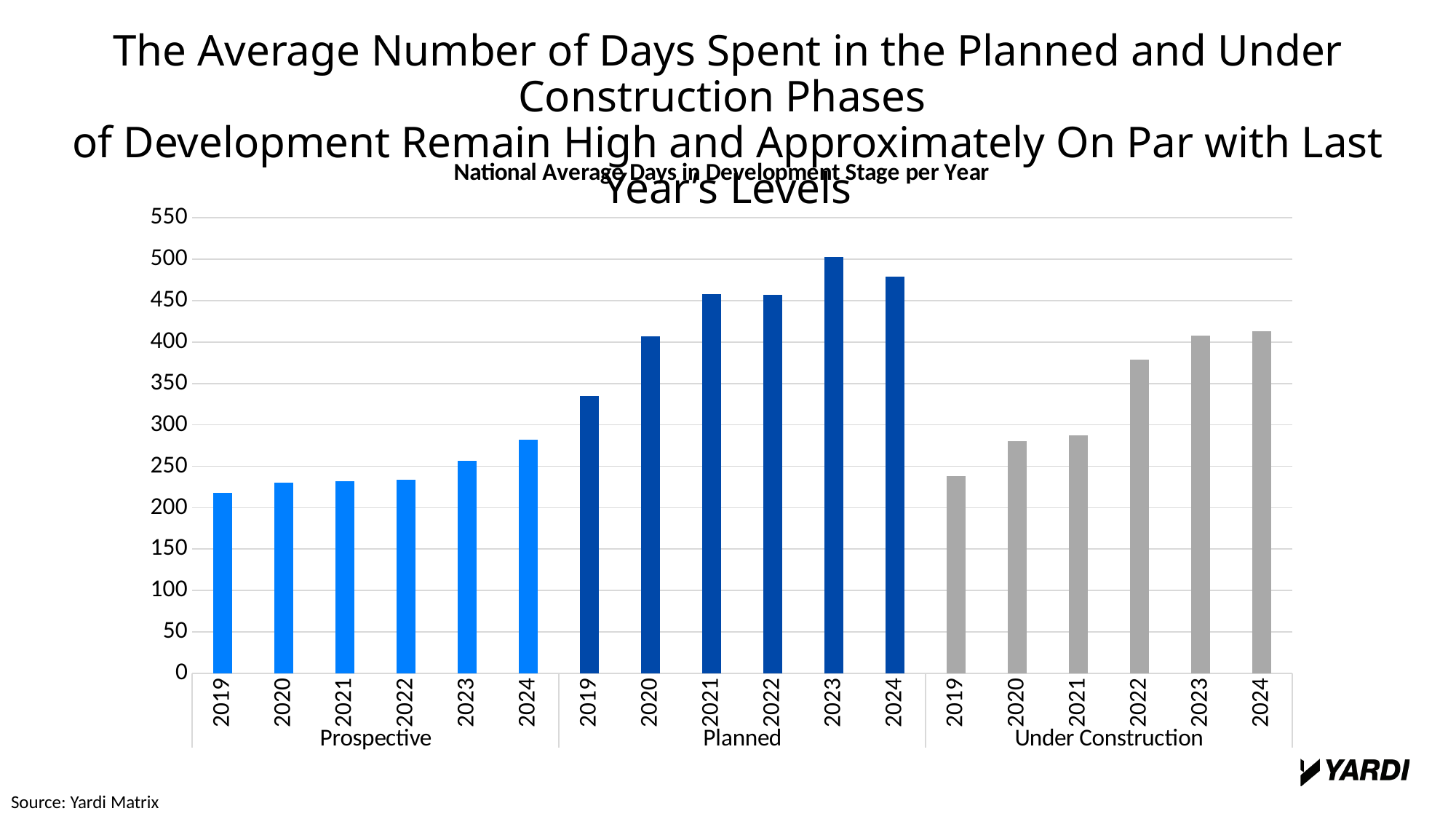
Which development stage and year has the highest average number of days? Planned, 2023 Which is larger: the value for Prospective in 2023 or the value for Under Construction in 2023? Under Construction in 2023 Is the value for Prospective in 2024 greater or less than 300? less Which is larger: the value for Planned in 2021 or the value for Under Construction in 2021? Planned in 2021 Is the value for Under Construction in 2022 greater or less than 350? greater What kind of chart is shown on the slide? bar chart Is the value for Planned in 2019 greater or less than 300? greater Do the Prospective values rise or fall from 2019 to 2024? rise How many bars are plotted in the chart? 18 Which development stage and year has the lowest average number of days? Prospective, 2019 What is the title printed directly above the chart? National Average Days in Development Stage per Year